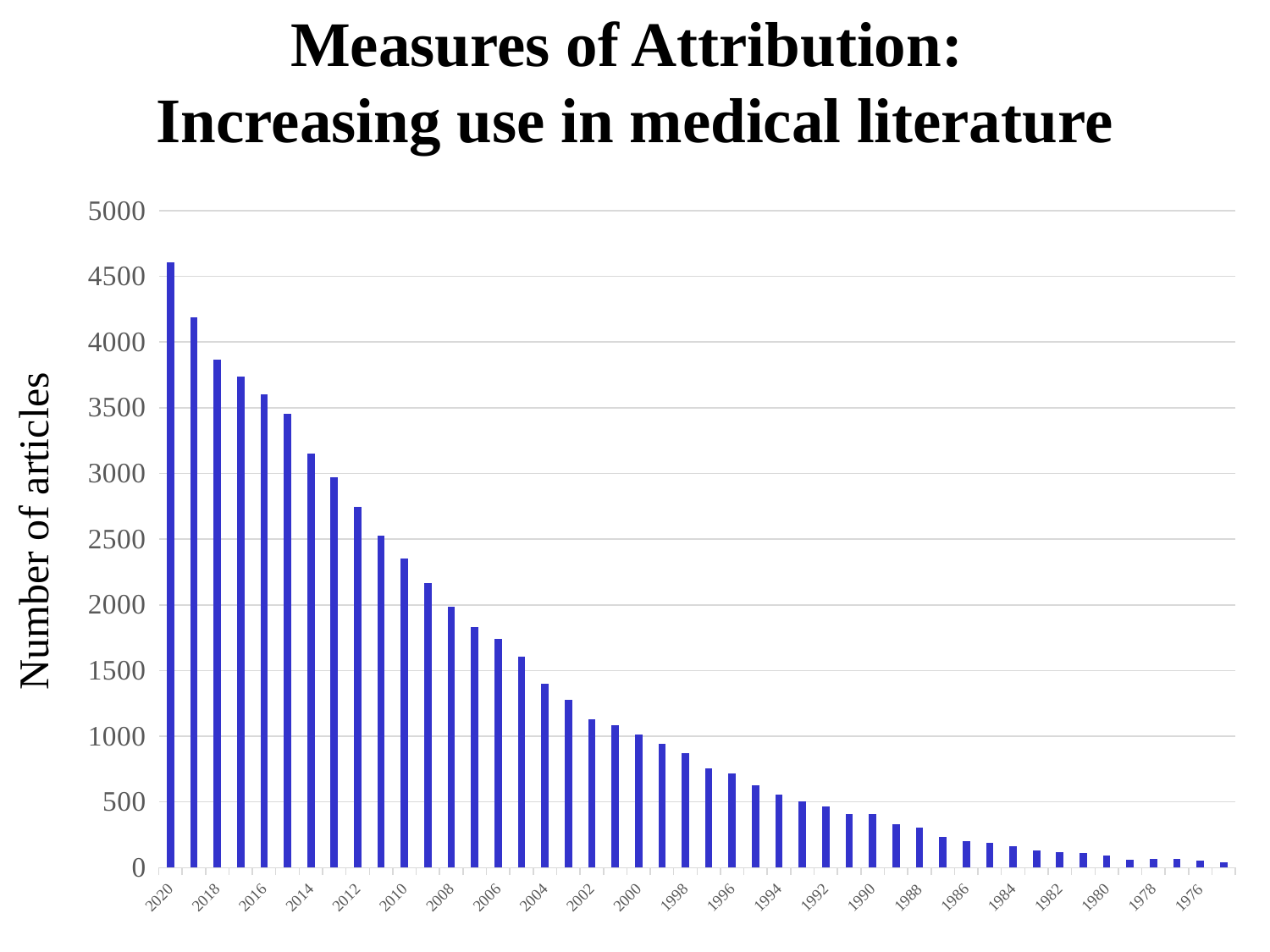
Is the number of articles for 1998 greater or less than 1000? less Is the number of articles for 2014 greater or less than 3000? greater Is the number of articles for 2010 greater or less than 2500? less Which year has more articles, 2012 or 2002? 2012 Which year has the highest number of articles? 2020 What is the label of the y axis? Number of articles Do the values rise or fall moving from left (2020) to right (1976) along the x axis? fall What kind of chart is shown on the slide? bar chart